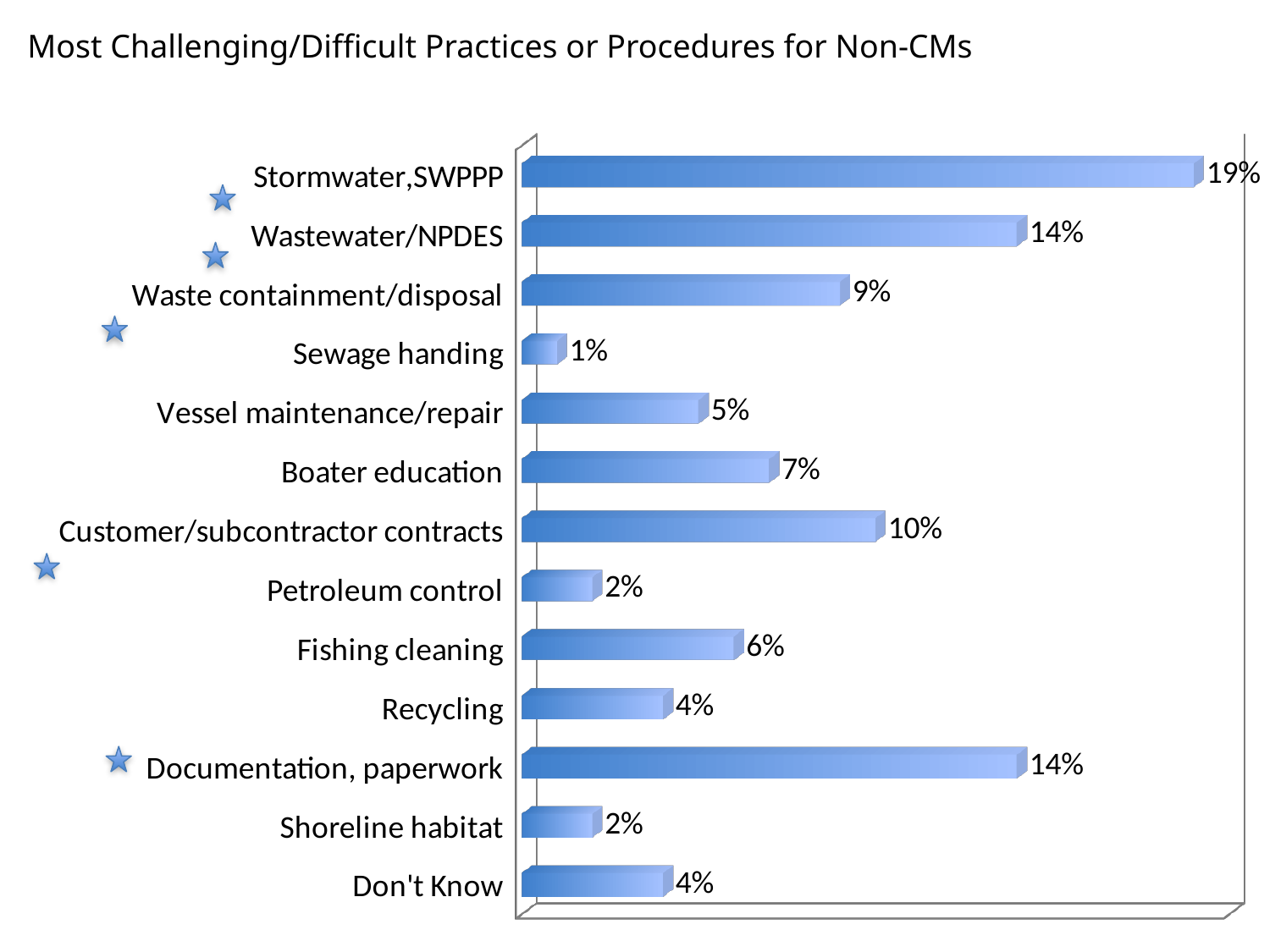
Which category has the lowest value? Sewage handing What percentage is shown for Stormwater,SWPPP? 19% How many categories are shown in the chart? 13 What percentage is shown for Customer/subcontractor contracts? 10% What is the difference between the values for Waste containment/disposal and Recycling? 5% What percentage is shown for Sewage handing? 1% What percentage is shown for Documentation, paperwork? 14% What kind of chart is shown on the slide? Bar chart What is the difference between the values for Stormwater,SWPPP and Wastewater/NPDES? 5% Which is larger, the value for Boater education or the value for Fishing cleaning? Boater education What is the title of the chart? Most Challenging/Difficult Practices or Procedures for Non-CMs Which category has the highest value? Stormwater,SWPPP